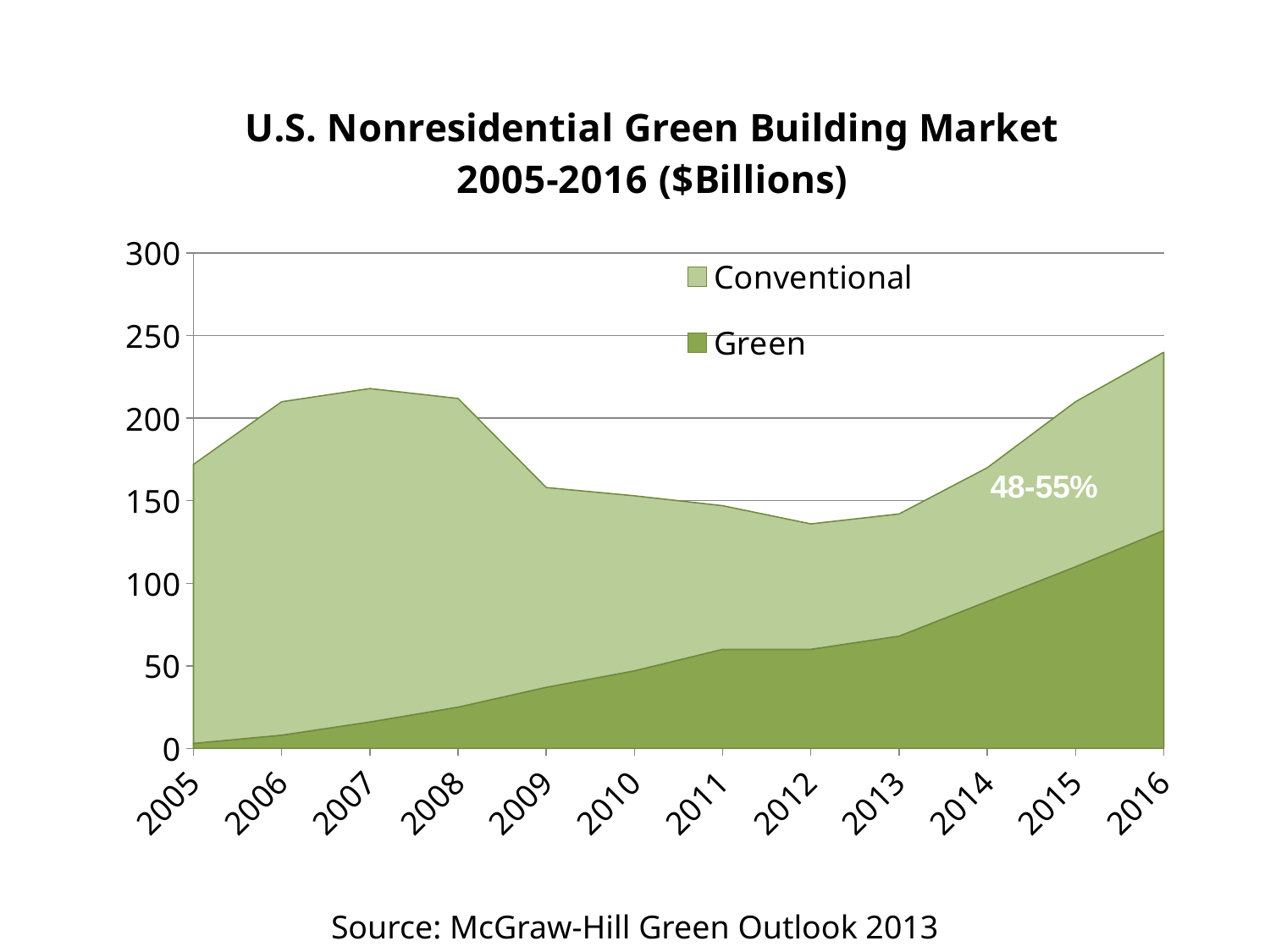
Is the value of the Green series in 2005 greater or less than 50? less What percentage range is annotated on the chart near 2014? 48-55% In which year is the Green series at its lowest? 2005 What kind of chart is shown on the slide? Stacked area chart Is the value of the Green series in 2016 greater or less than 100? greater Is the total market value (top of the stacked area) in 2012 greater or less than 150? less How many series does the legend list? 2 How many years are shown along the x axis? 12 In which year is the Green series at its highest? 2016 Does the Green series rise or fall from 2005 to 2016? Rises Which year has the highest total market value (top of the stacked area)? 2016